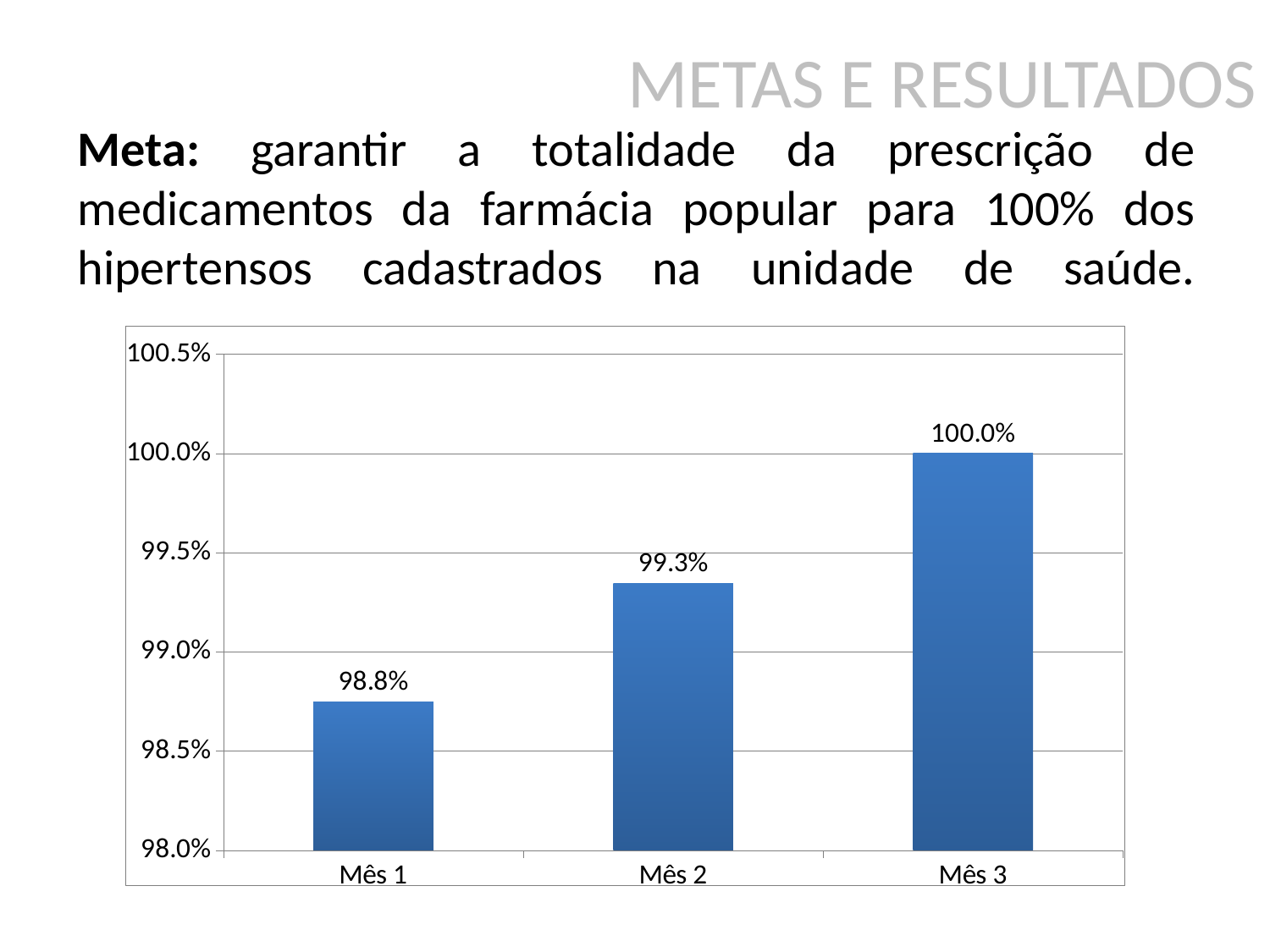
What kind of chart is shown on the slide? bar chart Which month has the highest value? Mês 3 How many categories are shown on the x axis? 3 Do the values rise or fall from Mês 1 to Mês 3? rise What is the difference between the values for Mês 2 and Mês 1? 0.5% Which month has the lowest value? Mês 1 What is the difference between the values for Mês 3 and Mês 1? 1.2% Is the value for Mês 1 greater or less than 99.0%? less What is the value for Mês 2? 99.3% What is the value for Mês 1? 98.8% Which is larger, the value for Mês 2 or the value for Mês 1? Mês 2 What is the value for Mês 3? 100.0%